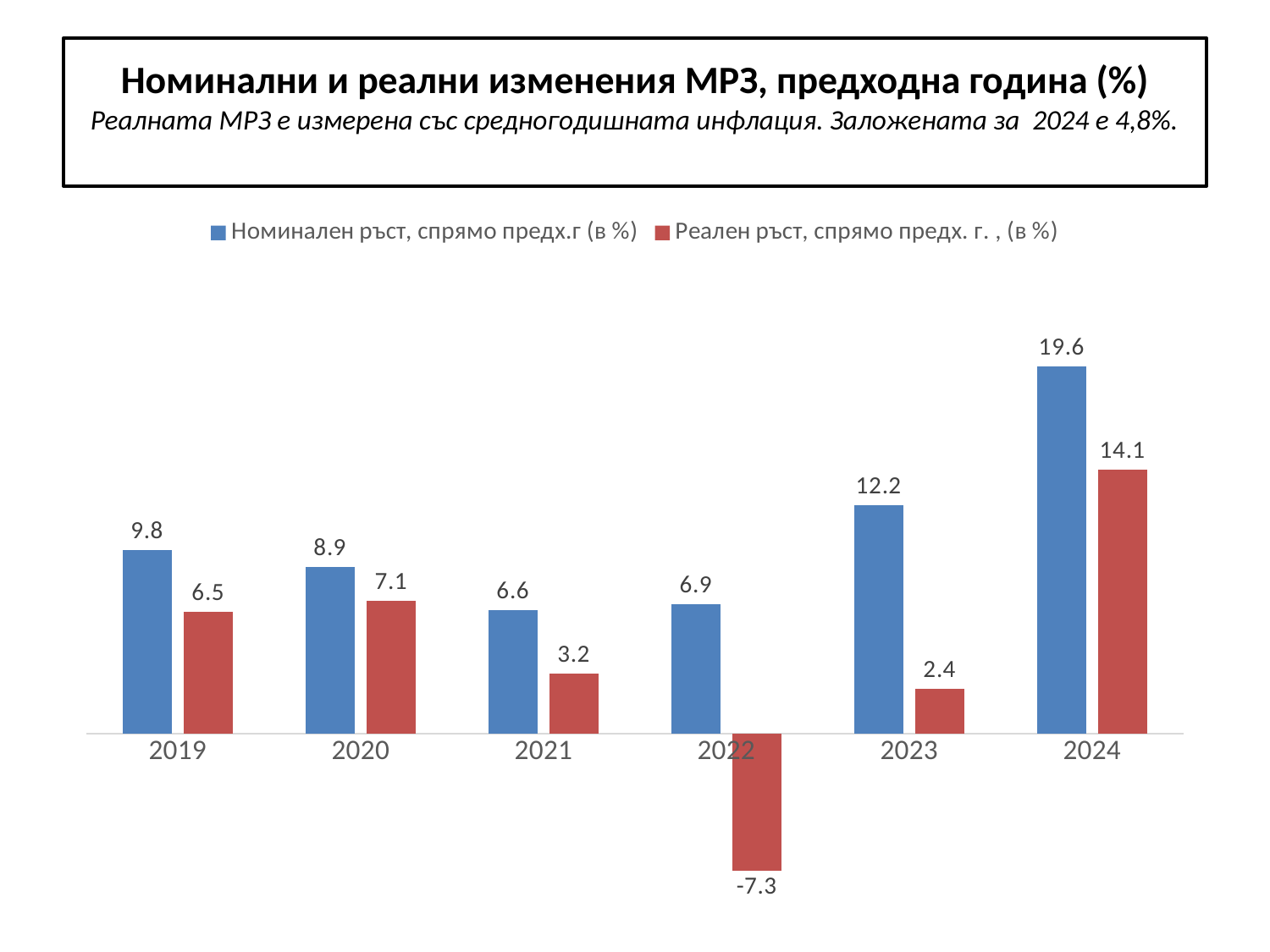
What is the difference between nominal growth and real growth in 2023? 9.8 Which year has the highest nominal growth (Номинален ръст)? 2024 How many series does the legend list? 2 Which year has the lowest real growth (Реален ръст)? 2022 Which colour represents real growth (Реален ръст) in the chart? Red What is the nominal growth (Номинален ръст) value for 2024? 19.6 Which is larger in 2020: nominal growth or real growth? Nominal growth (8.9) What is the real growth (Реален ръст) value for 2020? 7.1 What is the real growth (Реален ръст) value for 2022? -7.3 Which year has the lowest nominal growth (Номинален ръст)? 2021 How many years are shown on the x axis? 6 What kind of chart is shown on the slide? Bar chart